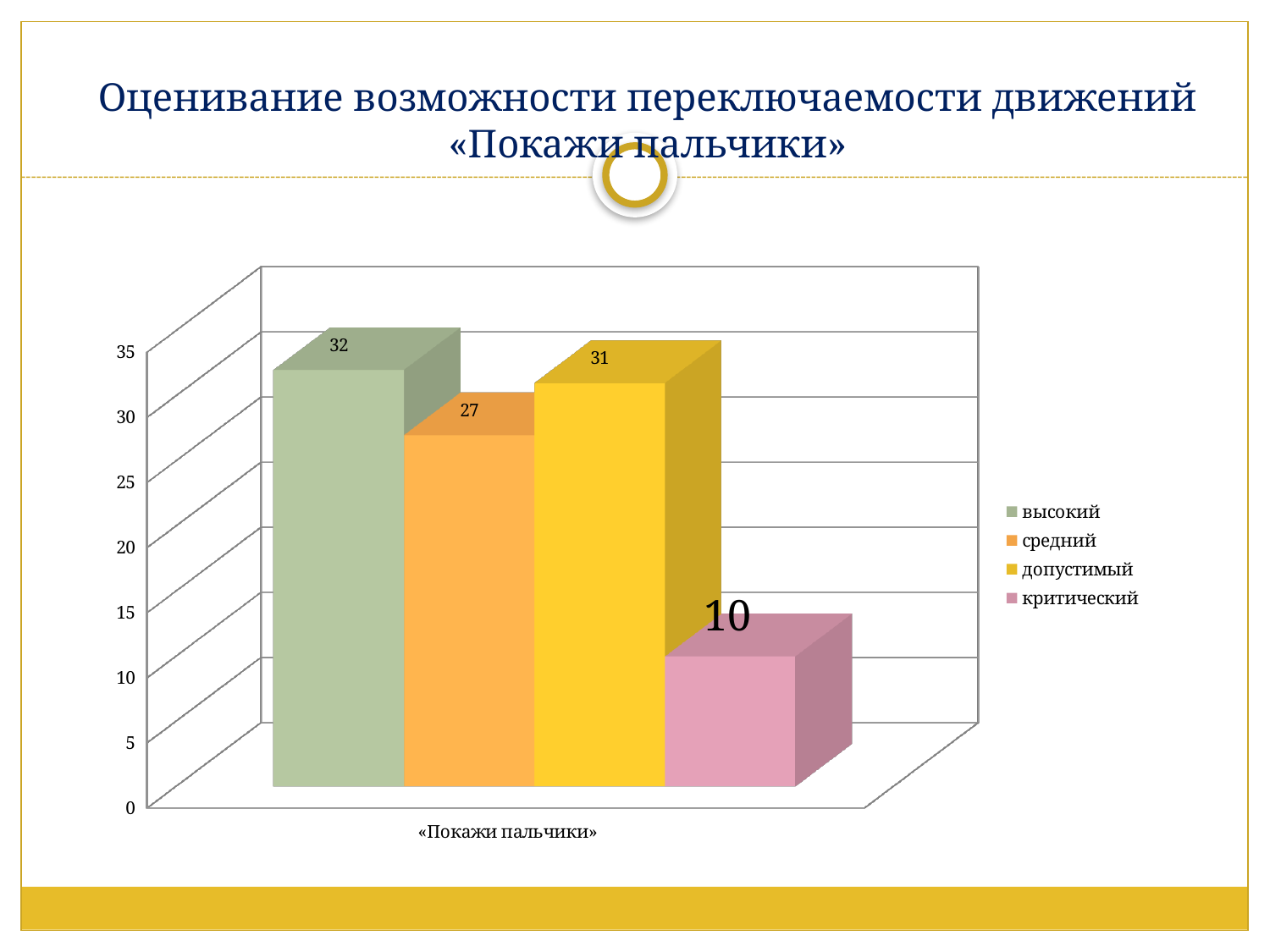
What is the difference between the values for «высокий» and «критический»? 22 What kind of chart is shown on the slide? bar chart What is the difference between the values for «допустимый» and «средний»? 4 What is the value for the series «средний»? 27 How many series does the legend list? 4 Which is larger, the value for «средний» or the value for «допустимый»? допустимый What is the category label shown on the x axis? «Покажи пальчики» Which series has the lowest value? критический What is the value for the series «критический»? 10 What is the value for the series «допустимый»? 31 Which series has the highest value? высокий What is the value for the series «высокий»? 32